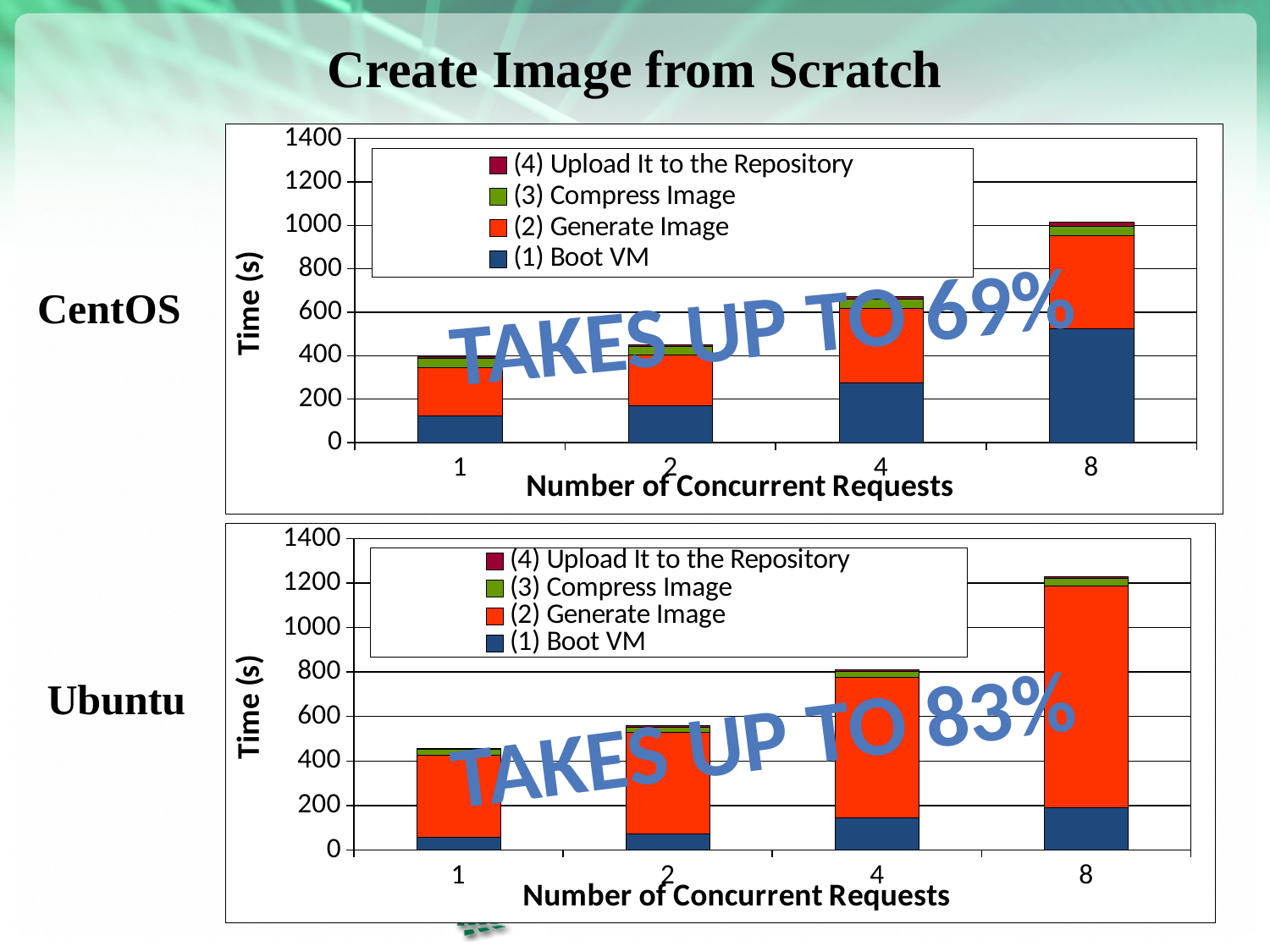
In the CentOS chart, which is larger: the total bar for 4 concurrent requests or for 2 concurrent requests? 4 concurrent requests In the Ubuntu chart, is the total time for 4 concurrent requests greater or less than 600? greater In the Ubuntu chart, does the total time rise or fall as the number of concurrent requests increases? rise In the Ubuntu chart, is the total time for 8 concurrent requests greater or less than 1000? greater What is the y-axis title of the Ubuntu chart? Time (s) How many series does the legend of the Ubuntu chart list? 4 In the Ubuntu chart, which number of concurrent requests has the shortest total bar? 1 What kind of chart is the CentOS chart? Stacked bar chart In the CentOS chart, is the total time for 1 concurrent request greater or less than 600? less How many categories are shown on the x axis of the CentOS chart? 4 In the CentOS chart, which number of concurrent requests has the tallest total bar? 8